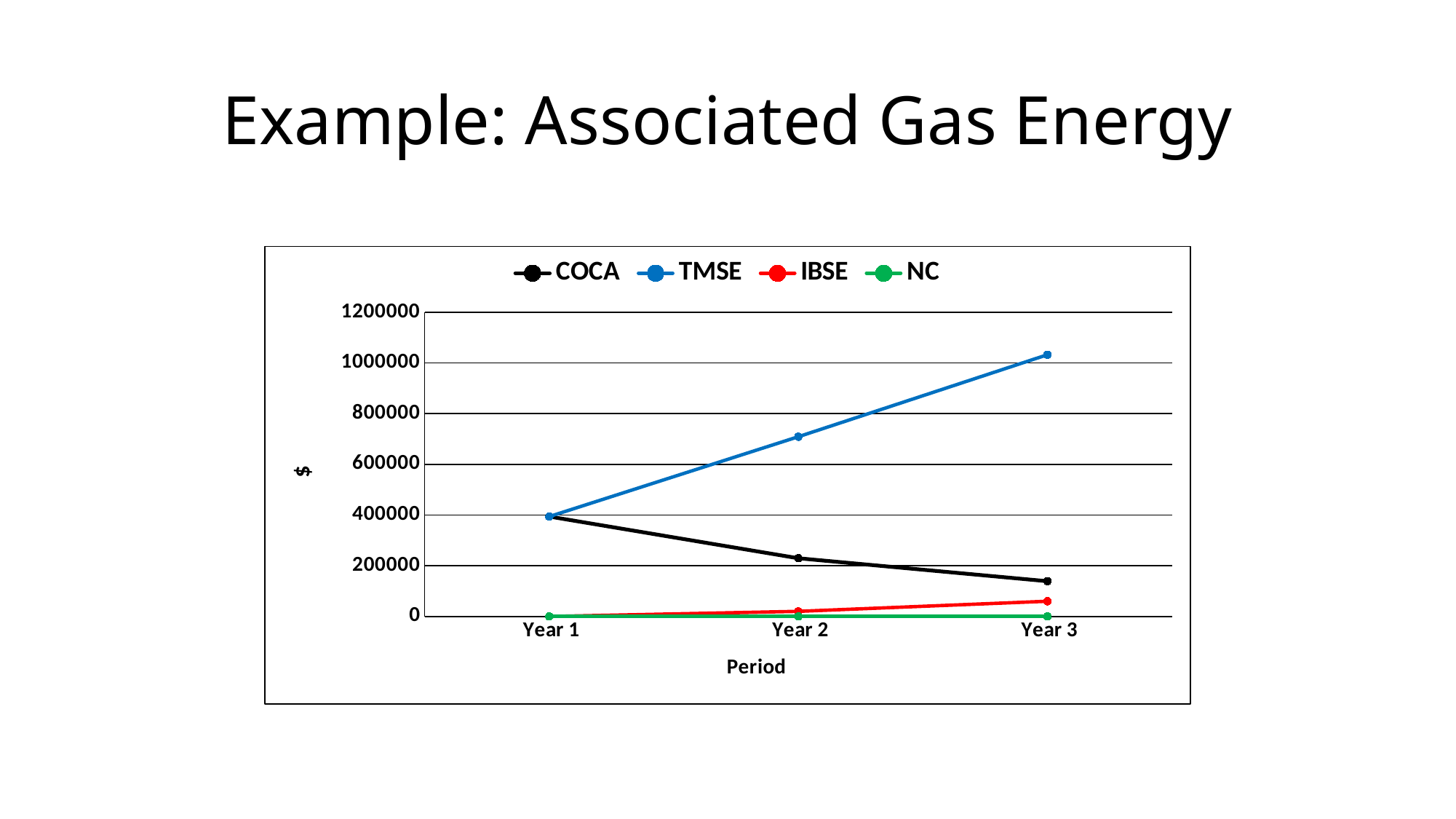
What kind of chart is shown on the slide? line chart Which series has the lowest value in Year 3? NC Is the value for TMSE in Year 3 greater or less than 800000? greater In Year 3, which is larger, IBSE or NC? IBSE Is the value for COCA in Year 3 greater or less than 200000? less What is the title of the x axis? Period How many periods are plotted along the x axis? 3 How many series does the legend list? 4 Does the COCA line rise or fall from Year 1 to Year 3? fall Which series has the highest value in Year 3? TMSE Does the TMSE line rise or fall from Year 1 to Year 3? rise In Year 2, which is larger, TMSE or COCA? TMSE